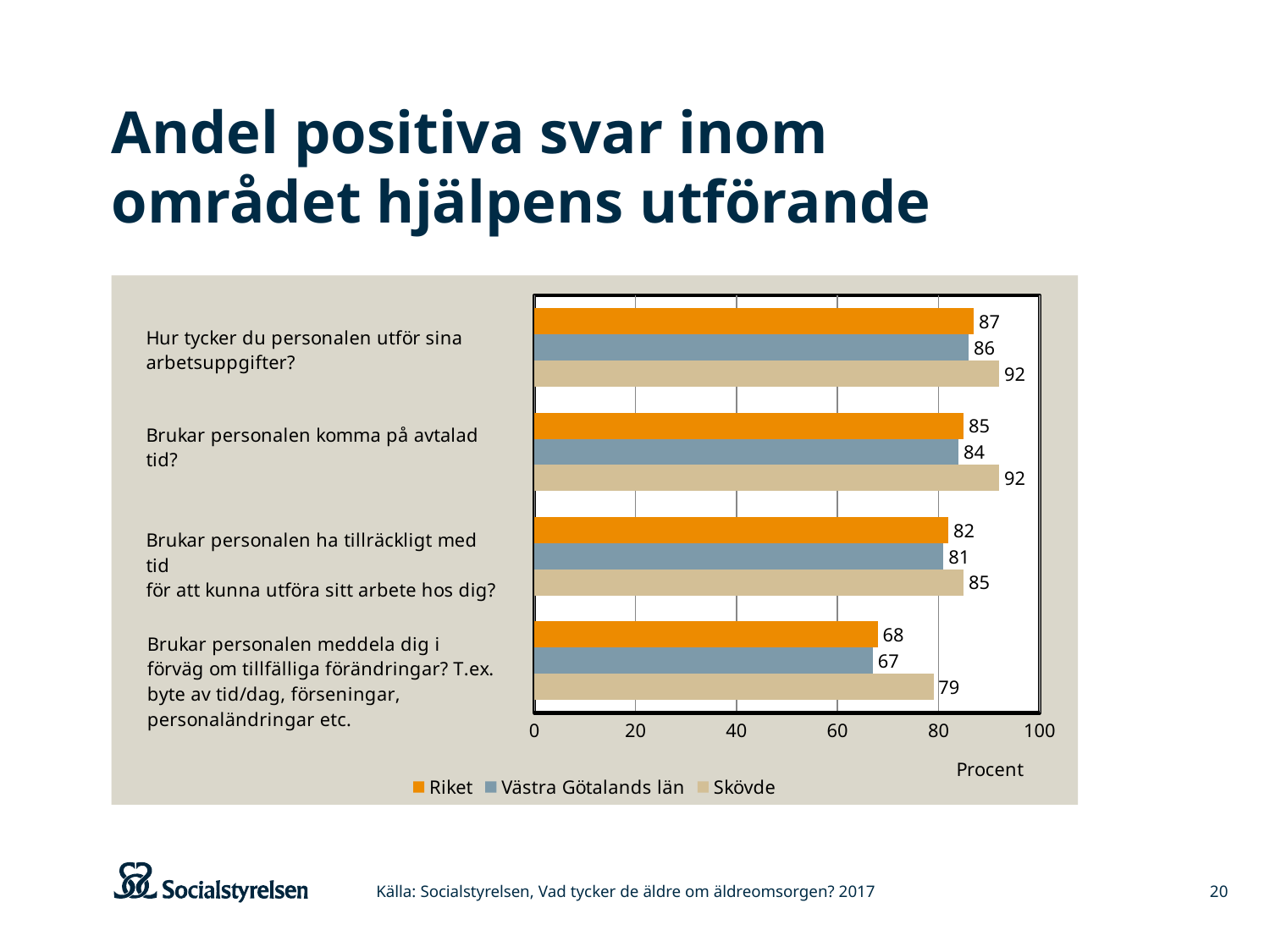
Which series has the highest value for the question "Brukar personalen ha tillräckligt med tid för att kunna utföra sitt arbete hos dig?"? Skövde How many questions (categories) are shown in the chart? 4 How many series does the legend list? 3 Is the value for Riket for the question "Brukar personalen meddela dig i förväg om tillfälliga förändringar?" greater or less than 80? less What is the label on the horizontal axis of the chart? Procent Which question has the lowest value for Skövde? Brukar personalen meddela dig i förväg om tillfälliga förändringar? What is the value for Riket for the question "Brukar personalen komma på avtalad tid?"? 85 What kind of chart is shown on the slide? bar chart Which is larger for the question "Brukar personalen komma på avtalad tid?": Riket or Västra Götalands län? Riket What is the value for Västra Götalands län for the question "Brukar personalen meddela dig i förväg om tillfälliga förändringar?"? 67 What is the difference between the Skövde and Riket values for the question "Brukar personalen meddela dig i förväg om tillfälliga förändringar?"? 11 What is the value for Skövde for the question "Hur tycker du personalen utför sina arbetsuppgifter?"? 92